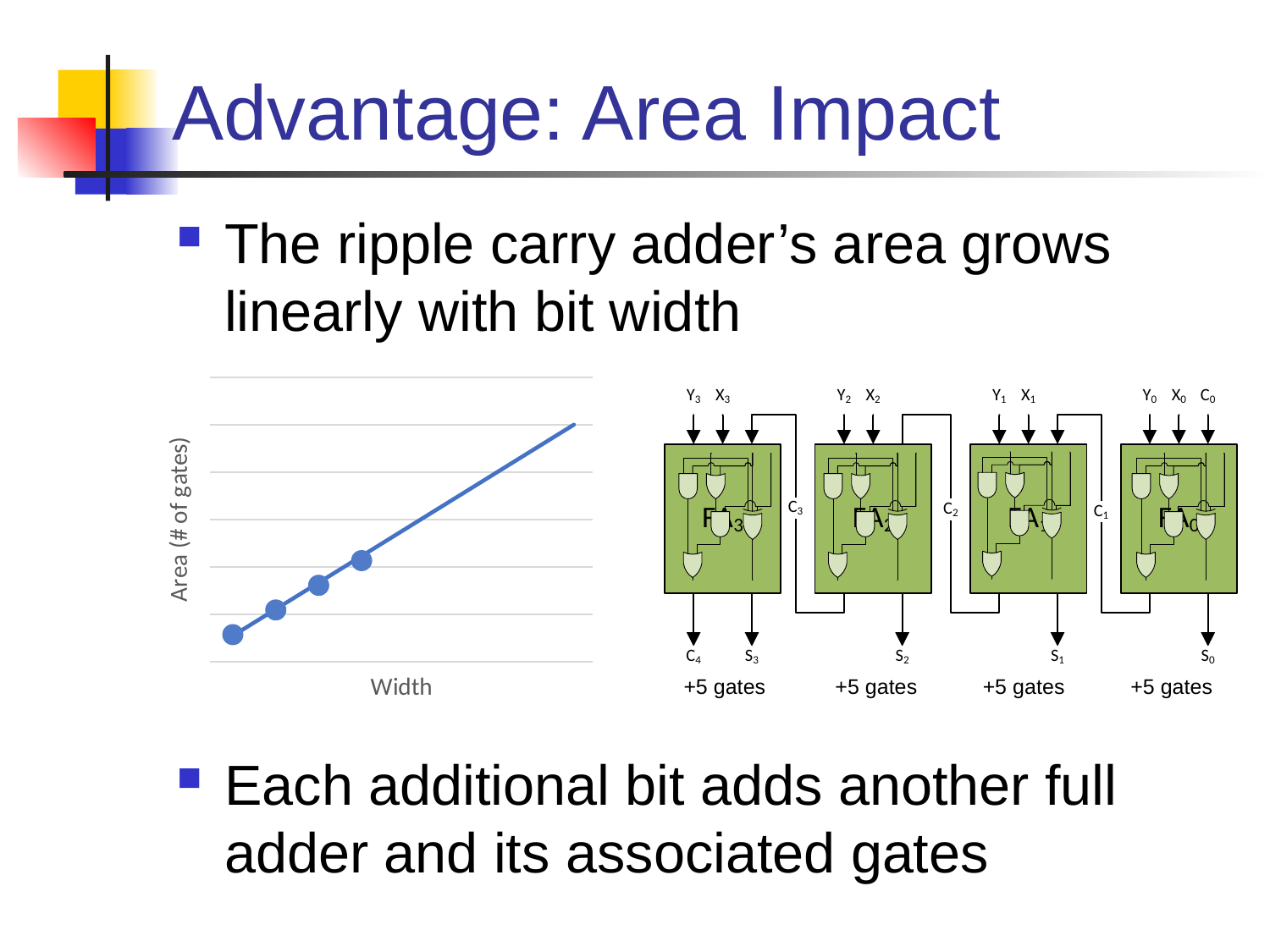
Does the chart show a linear or a curved relationship between Width and Area? linear Do the values in the chart rise or fall as Width increases along the x axis? rise What is the label of the horizontal axis of the chart? Width What kind of chart is shown on the left of the slide? line chart How many marked data points are plotted on the line in the chart? 4 What is the label of the vertical axis of the chart? Area (# of gates)